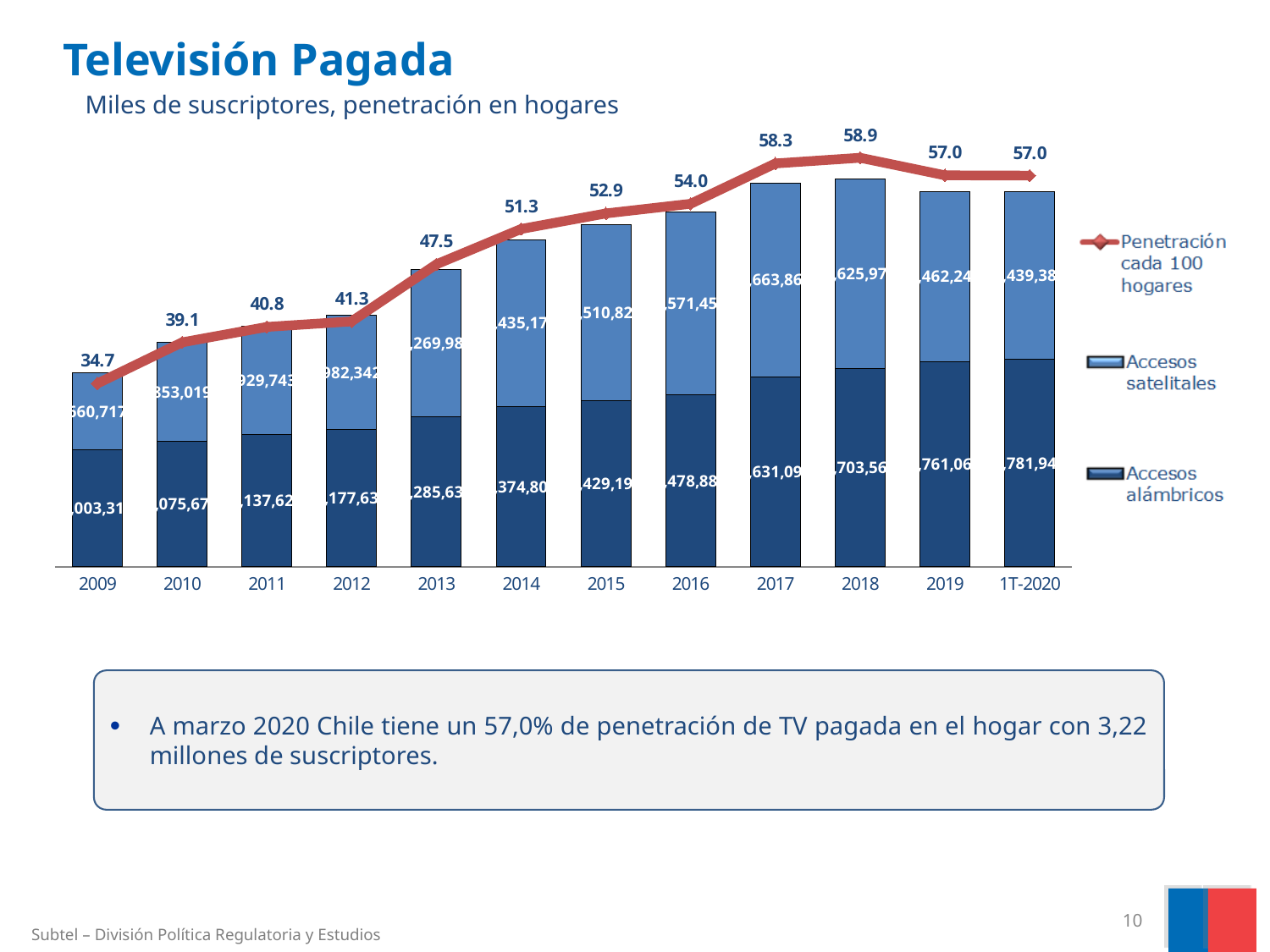
What is the difference in Penetración cada 100 hogares between 2017 and 2016? 4.3 In which year is Penetración cada 100 hogares lowest? 2009 What is the value of Penetración cada 100 hogares for 2009? 34.7 In which year is Penetración cada 100 hogares highest? 2018 How many series does the legend list? 3 Which is larger in 2019, Accesos alámbricos or Accesos satelitales? Accesos alámbricos Does Penetración cada 100 hogares generally rise or fall from 2009 to 2018? Rise How many time periods are shown on the x axis? 12 What is the difference in Penetración cada 100 hogares between 2018 and 2009? 24.2 What kind of chart is shown on the slide? Stacked bar chart with a line What is the value of Penetración cada 100 hogares for 1T-2020? 57.0 What is the value of Penetración cada 100 hogares for 2016? 54.0